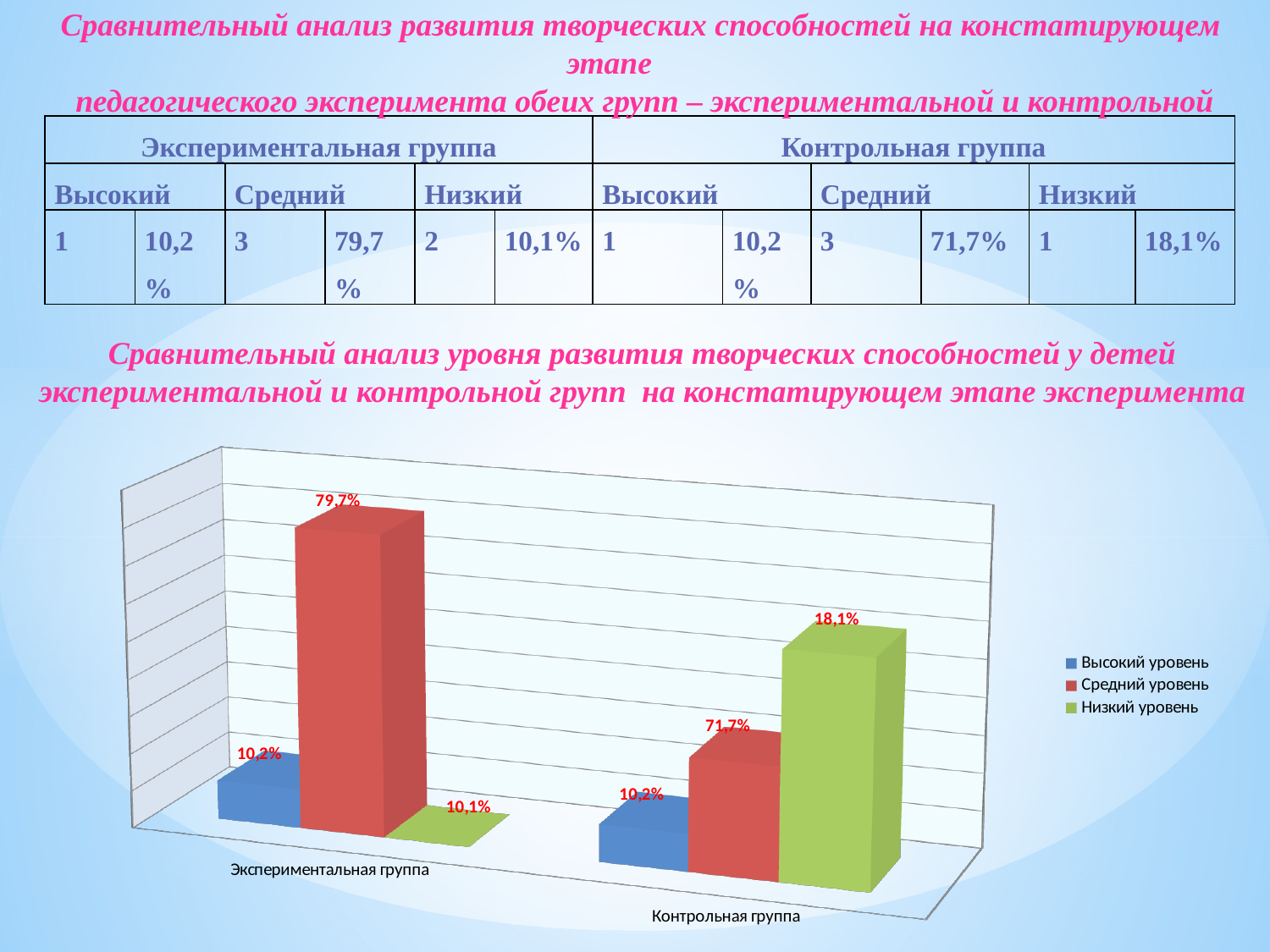
What is the value for Высокий уровень in the Контрольная группа? 10,2% What is the value for Средний уровень in the Экспериментальная группа? 79,7% What is the value for Низкий уровень in the Экспериментальная группа? 10,1% Which level has the lowest value in the Контрольная группа? Высокий уровень Which level has the highest value in the Экспериментальная группа? Средний уровень Which group has the larger value for Низкий уровень, Экспериментальная группа or Контрольная группа? Контрольная группа How many series does the chart legend list? 3 How many groups (categories) are plotted on the x axis of the chart? 2 Which colour represents Низкий уровень in the chart legend? green What is the difference between the Средний уровень values of the Экспериментальная группа and the Контрольная группа? 8% What is the value for Низкий уровень in the Контрольная группа? 18,1% What type of chart is shown on the slide? bar chart